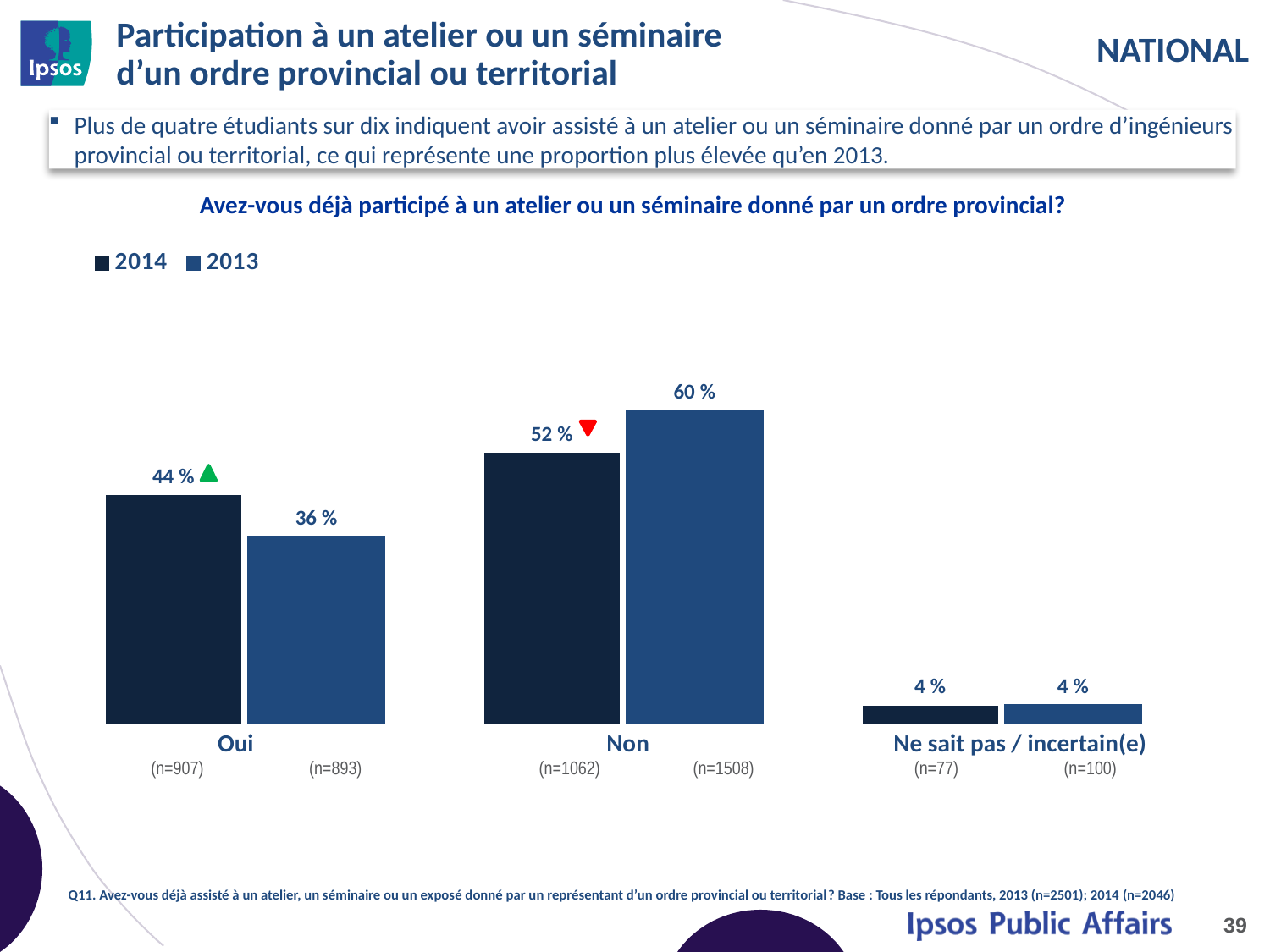
What is the value for "Non" in the 2013 series? 60 % For "Oui", which series has the larger value, 2014 or 2013? 2014 What is the sample size (n) shown for "Non" in 2013? n=1508 What is the value for "Ne sait pas / incertain(e)" in the 2014 series? 4 % How many categories are shown on the x axis? 3 What is the value for "Oui" in the 2014 series? 44 % What is the difference between the 2013 and 2014 values for "Non"? 8 % What is the difference between the 2014 and 2013 values for "Oui"? 8 % Which category has the highest value in the 2014 series? Non How many series does the legend list? 2 Which category has the lowest value in the 2013 series? Ne sait pas / incertain(e) What kind of chart is shown on the slide? Bar chart